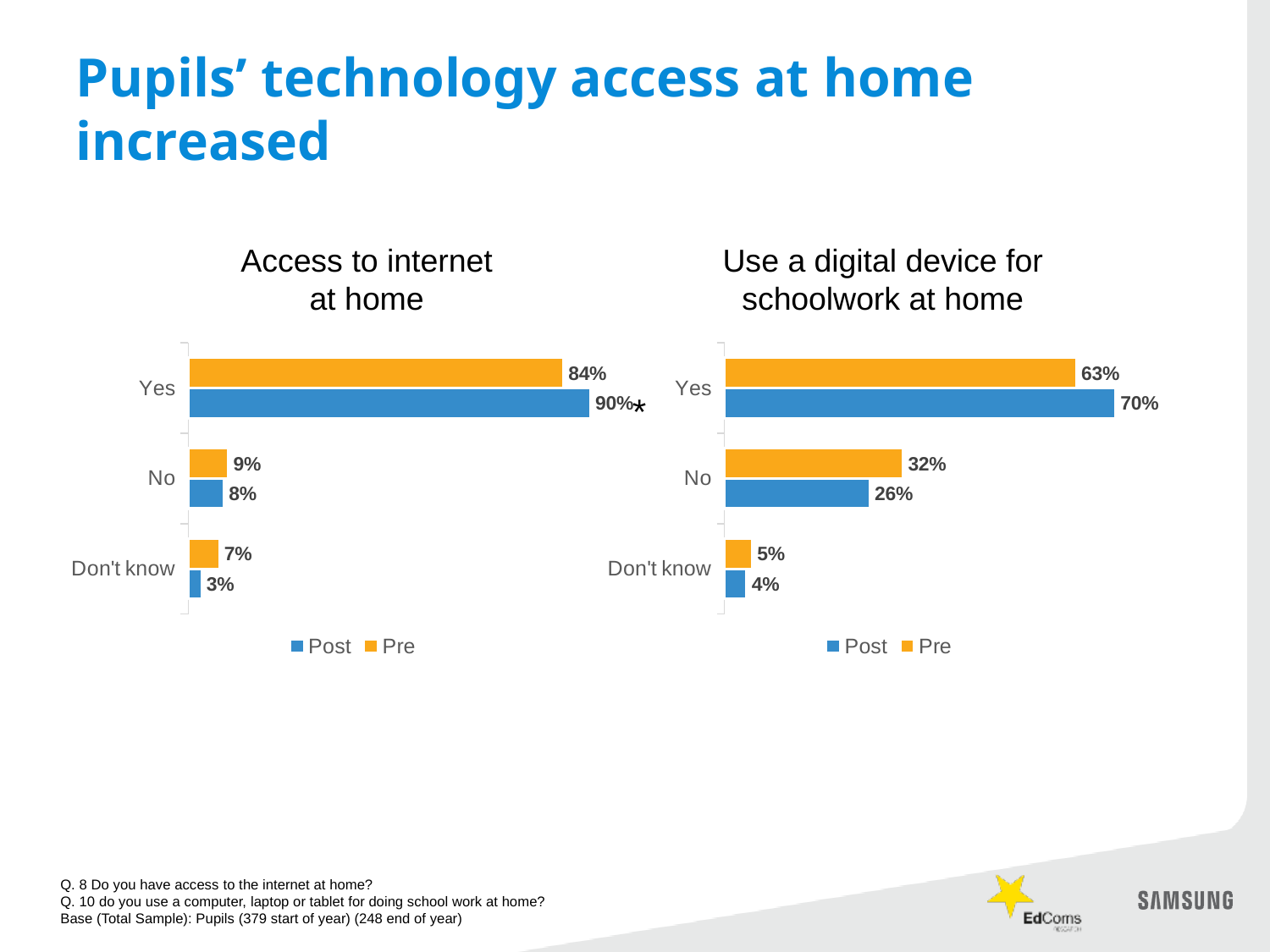
In the 'Access to internet at home' chart, what is the Post value for Yes? 90% In the 'Access to internet at home' chart, what is the difference between the Post and Pre values for Yes? 6% How many categories are shown in the 'Access to internet at home' chart? 3 In the 'Use a digital device for schoolwork at home' chart, is the Pre value for Yes larger or smaller than the Post value for Yes? smaller What type of chart is the 'Access to internet at home' chart? bar chart In the 'Access to internet at home' chart, what is the Pre value for Don't know? 7% In the 'Use a digital device for schoolwork at home' chart, what is the Pre value for No? 32% In the 'Use a digital device for schoolwork at home' chart, which category has the highest Post value? Yes In the 'Use a digital device for schoolwork at home' chart, what is the difference between the Pre and Post values for No? 6% In the 'Access to internet at home' chart, which category has the lowest Post value? Don't know How many series does the legend of the 'Use a digital device for schoolwork at home' chart list? 2 In the 'Use a digital device for schoolwork at home' chart, what is the Post value for Don't know? 4%